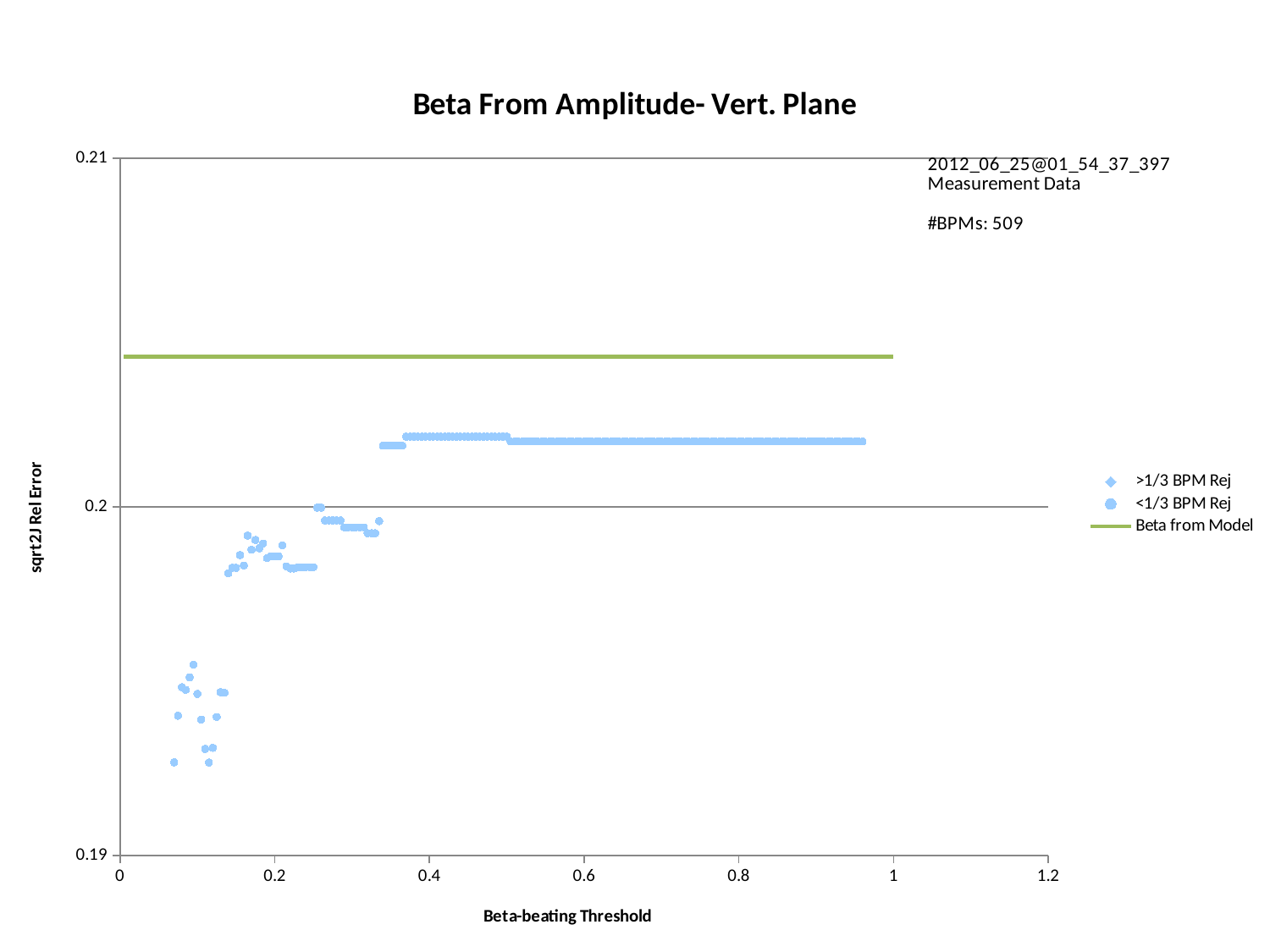
Do the <1/3 BPM Rej values generally rise or fall as the Beta-beating Threshold increases? rise Is the value of the Beta from Model line greater or less than 0.2? greater Is the value of the <1/3 BPM Rej points at a Beta-beating Threshold of 0.6 greater or less than 0.2? greater What kind of chart is shown on the slide? scatter chart Which is higher: the <1/3 BPM Rej points at a Beta-beating Threshold of 0.2 or those at 0.6? those at 0.6 Is the Beta from Model line greater or less than 0.21? less What is the title of the chart? Beta From Amplitude- Vert. Plane How many series does the chart's legend list? 3 Which is higher on the chart: the Beta from Model line or the <1/3 BPM Rej points at a Beta-beating Threshold of 0.8? Beta from Model What is the label of the x axis? Beta-beating Threshold